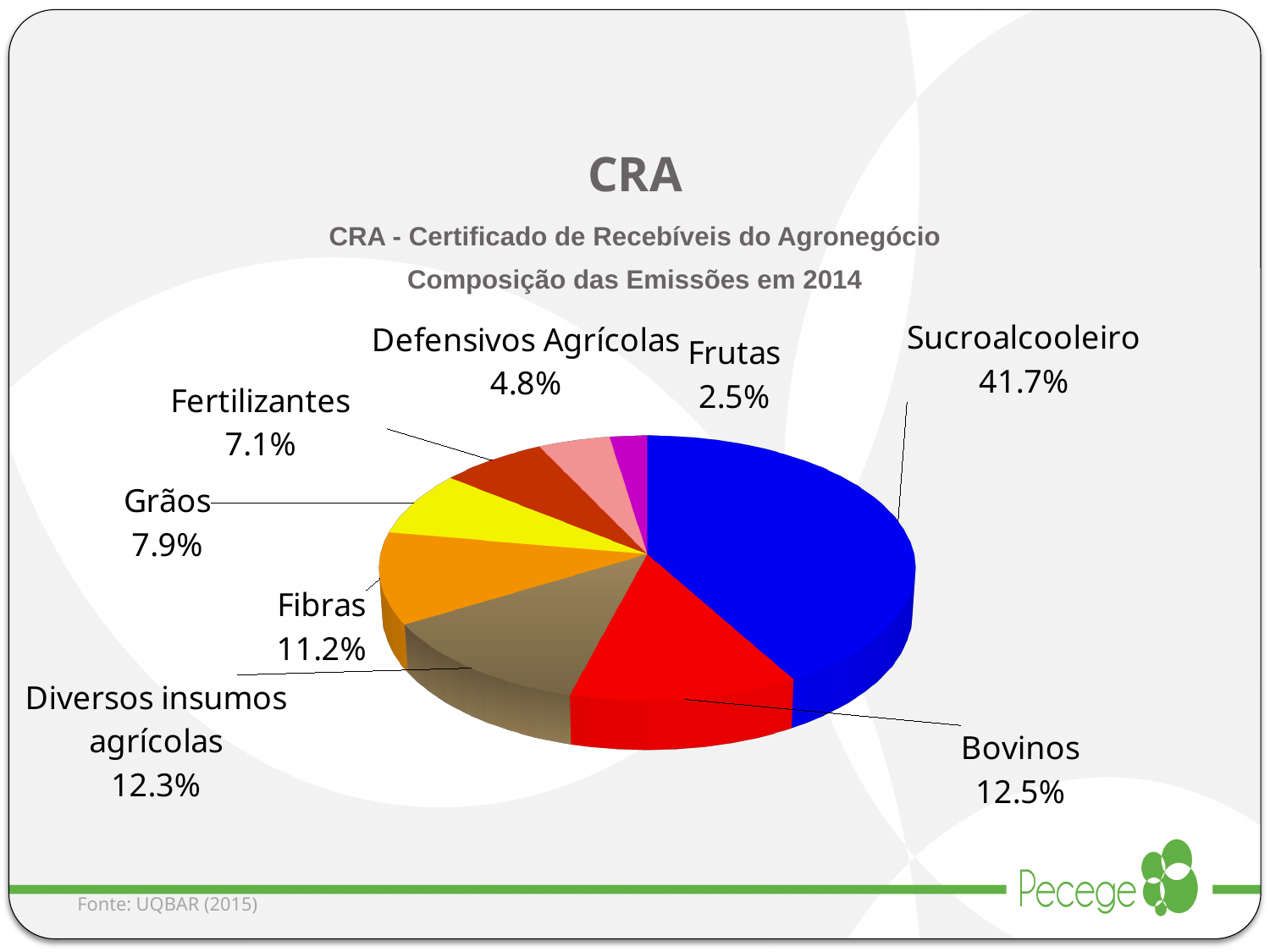
What share of CRA emissions in 2014 does Sucroalcooleiro account for? 41.7% What is the percentage shown for Fibras? 11.2% What is the percentage shown for Fertilizantes? 7.1% What is the subtitle describing the chart's content? Composição das Emissões em 2014 How many categories are shown in the pie chart? 8 Which category has the smallest slice of the pie? Frutas Which category has the largest slice of the pie? Sucroalcooleiro What is the difference in percentage points between Grãos and Fertilizantes? 0.8 Which is larger, the share for Fibras or the share for Grãos? Fibras What is the percentage shown for Frutas? 2.5% What type of chart is shown on the slide? Pie chart What is the difference in percentage points between Sucroalcooleiro and Bovinos? 29.2